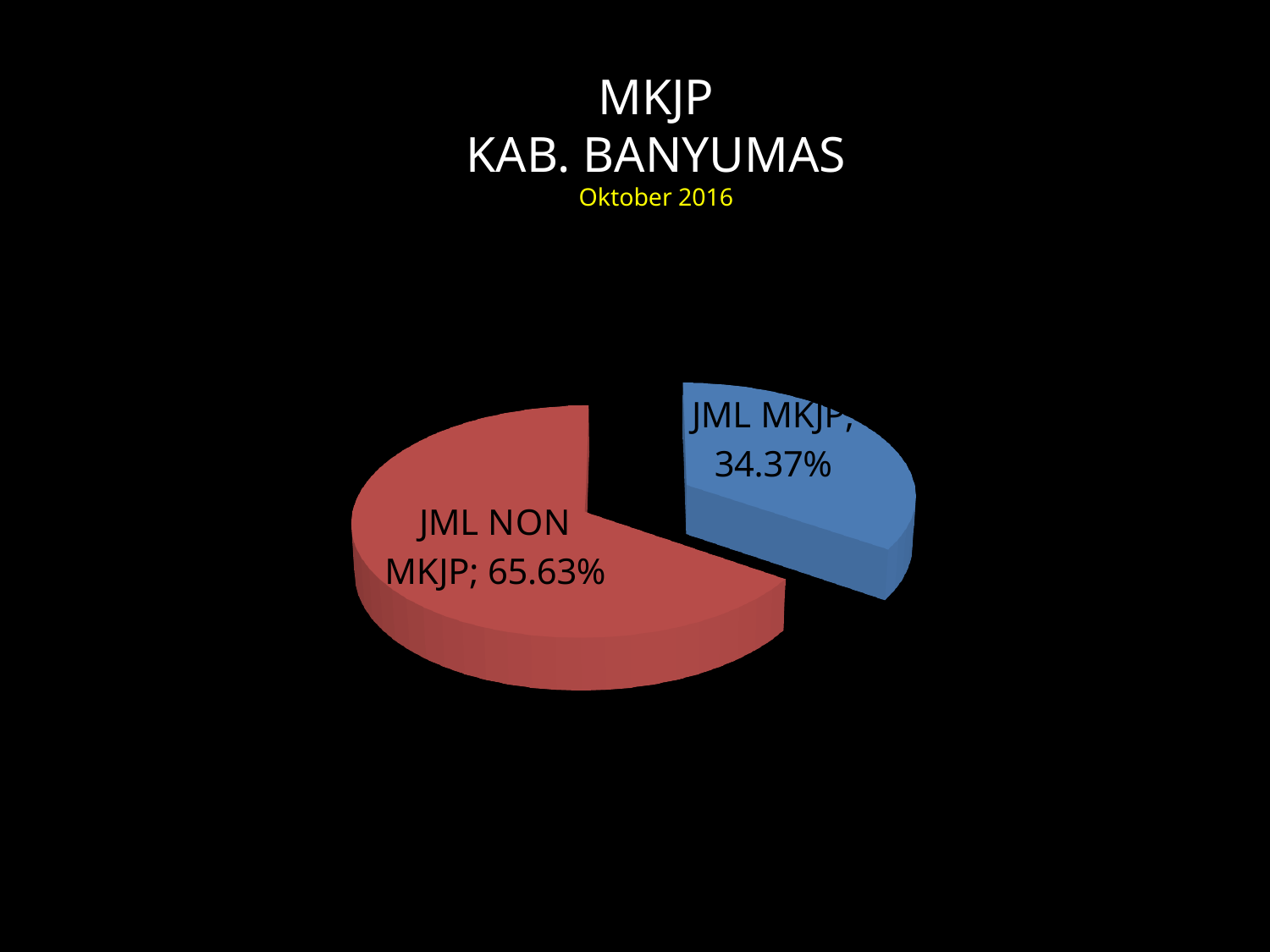
What colour is the JML MKJP slice? blue Which slice is the largest? JML NON MKJP How many slices does the pie chart have? 2 What kind of chart is shown on the slide? pie chart Which is larger, JML MKJP or JML NON MKJP? JML NON MKJP What month and year does the chart title refer to? Oktober 2016 What share of the pie does JML MKJP represent? 34.37% What is the difference in percentage points between JML NON MKJP and JML MKJP? 31.26 Which slice is the smallest? JML MKJP What share of the pie does JML NON MKJP represent? 65.63%